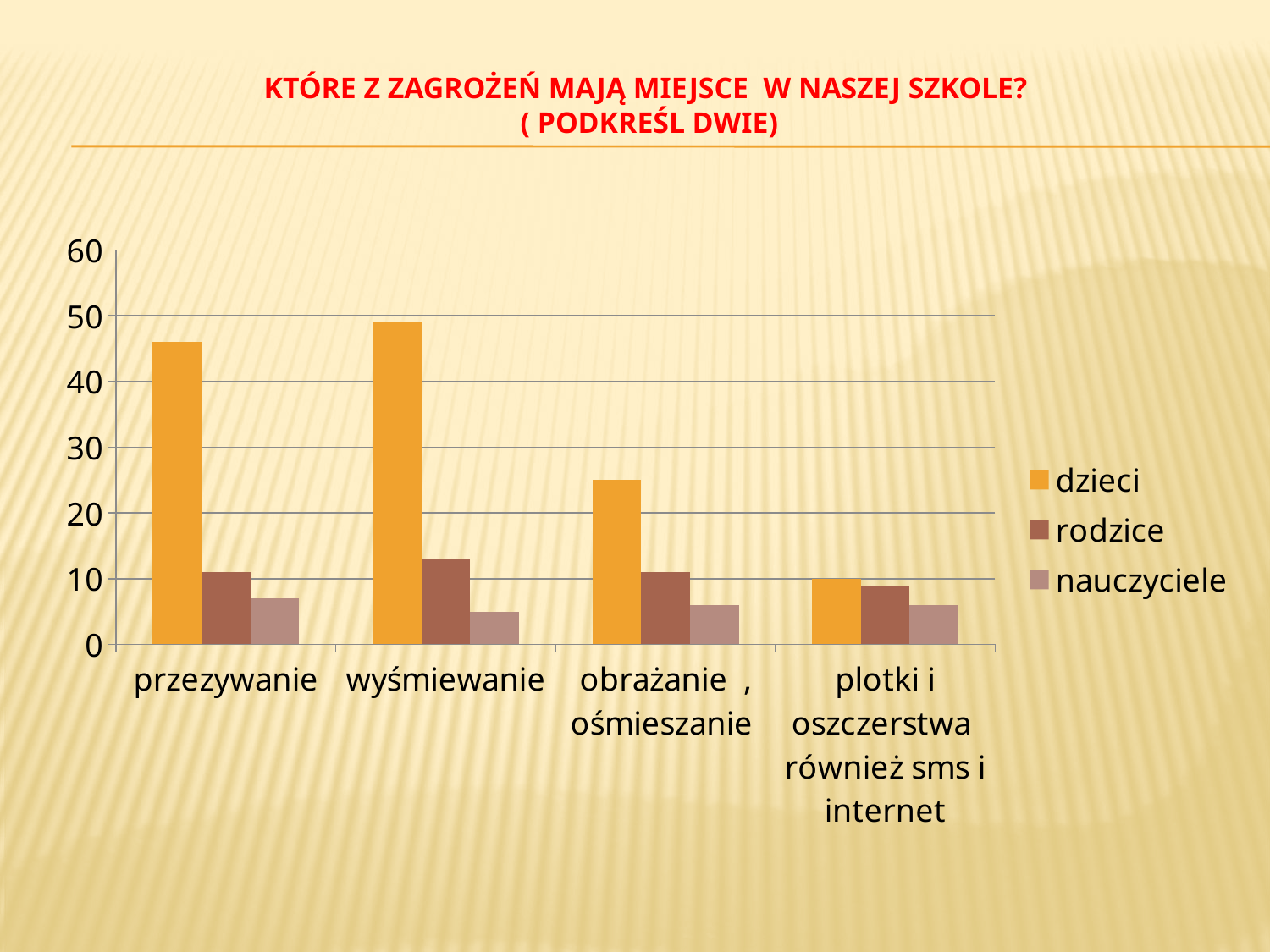
Is the dzieci value for przezywanie greater or less than 40? greater How many series does the legend list? 3 How many categories are shown on the x axis? 4 For which category is the dzieci value lowest? plotki i oszczerstwa również sms i internet Is the rodzice value for wyśmiewanie greater or less than 10? greater For which category is the dzieci value highest? wyśmiewanie Which series has the tallest bar in every category? dzieci What kind of chart is shown on the slide? bar chart Is the nauczyciele value for wyśmiewanie greater or less than 10? less Which is larger: the dzieci value for przezywanie or the dzieci value for obrażanie, ośmieszanie? przezywanie What colour are the bars for the nauczyciele series? grey-pink